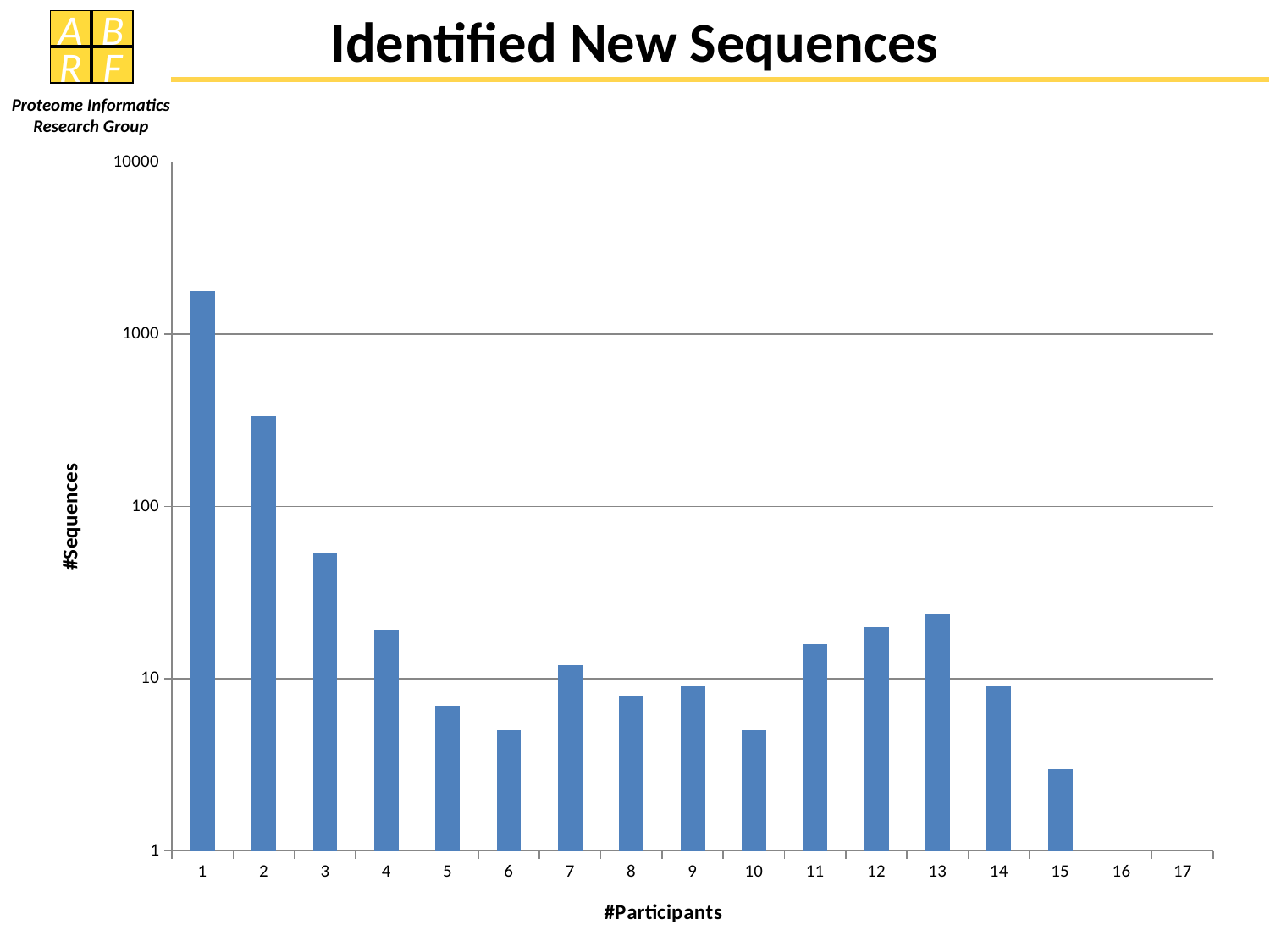
Which has more sequences, #Participants = 13 or #Participants = 12? 13 Is the value for #Participants = 3 greater or less than 100? less Is the value for #Participants = 2 greater or less than 1000? less Which #Participants category has the highest number of sequences? 1 What is the title of the chart? Identified New Sequences Among the bars shown, which #Participants category has the lowest number of sequences? 15 How many categories are shown on the x axis (#Participants)? 17 Do the values rise or fall from #Participants = 1 to #Participants = 6? fall Is the value for #Participants = 5 greater or less than 10? less What kind of chart is shown on the slide? bar chart What is the label of the y axis? #Sequences